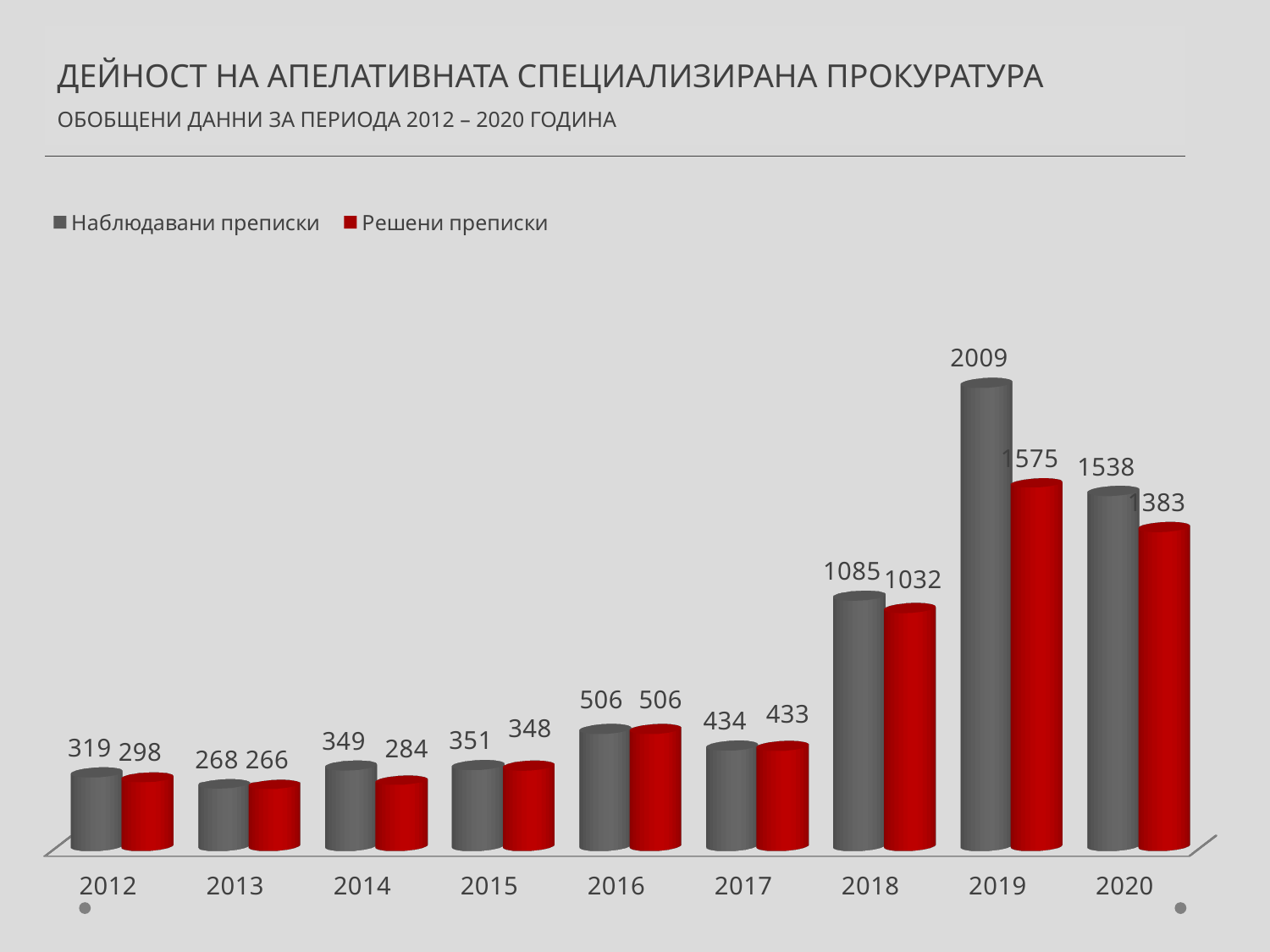
Which year has the lowest value for Решени преписки? 2013 What is the difference between Наблюдавани преписки in 2020 and in 2018? 453 Which is larger: Решени преписки in 2018 or Наблюдавани преписки in 2017? Решени преписки in 2018 What is the value of Решени преписки for 2014? 284 What kind of chart is shown on the slide? Bar chart Which year has the highest value for Наблюдавани преписки? 2019 How many series does the legend list? 2 Which colour represents Решени преписки in the chart? Red What is the value of Наблюдавани преписки for 2019? 2009 What is the difference between Наблюдавани преписки and Решени преписки in 2019? 434 What is the value of Решени преписки for 2020? 1383 How many years are shown on the x axis? 9